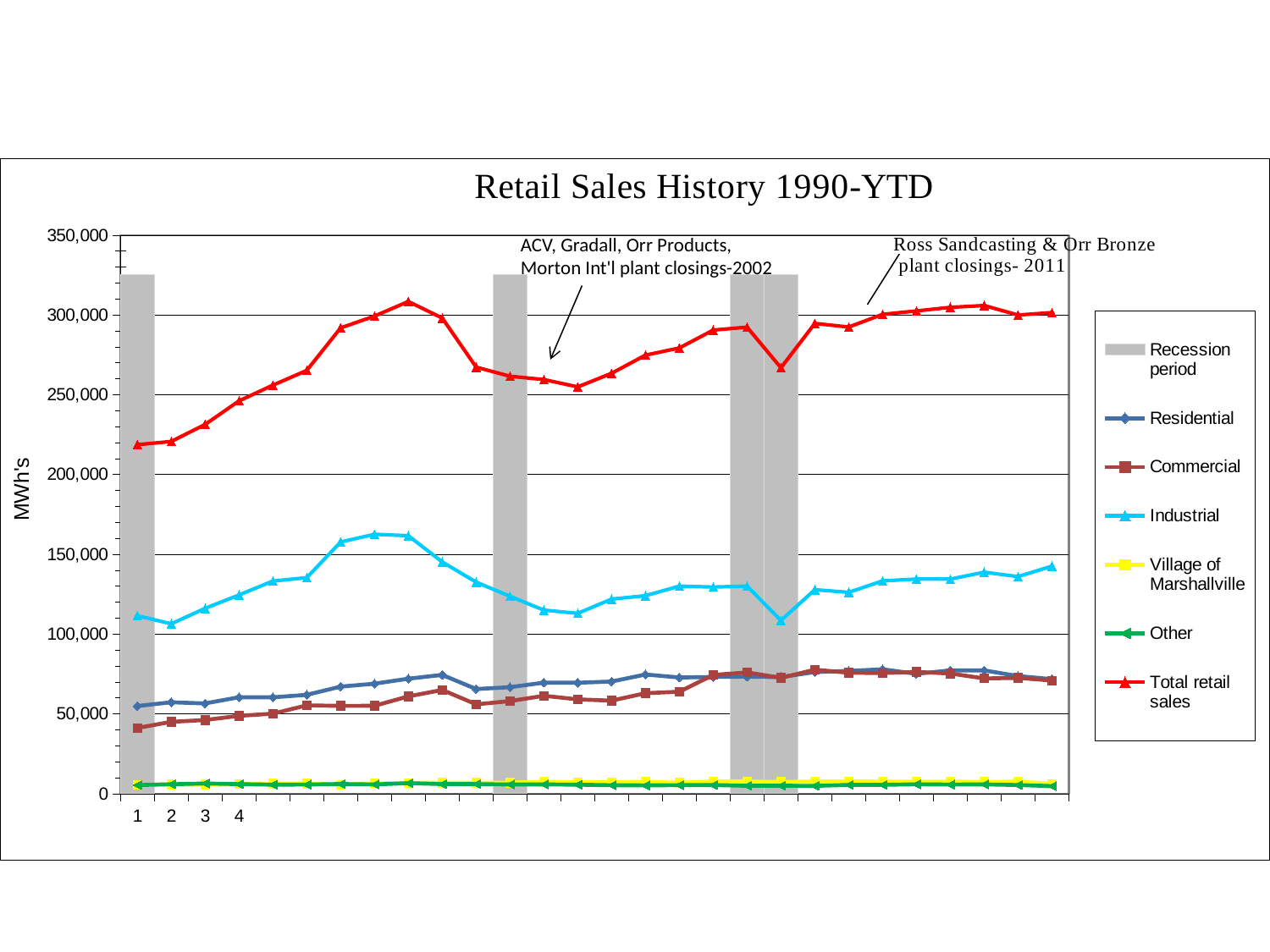
Is the value of Industrial at point 1 greater or less than 100,000? greater What is the label on the vertical axis of the chart? MWh's Is the value of Total retail sales at point 3 greater or less than 250,000? less Overall, does the Total retail sales line rise or fall from its first point to its last point? rise Is the value of Total retail sales at point 1 greater or less than 200,000? greater What is the title of the chart? Retail Sales History 1990-YTD How many entries does the chart's legend list? 7 At point 1, which is larger: Industrial or Residential? Industrial Which series has the highest values across the chart? Total retail sales At point 2, which is larger: Total retail sales or Industrial? Total retail sales What kind of chart is shown on the slide? combination bar and line chart